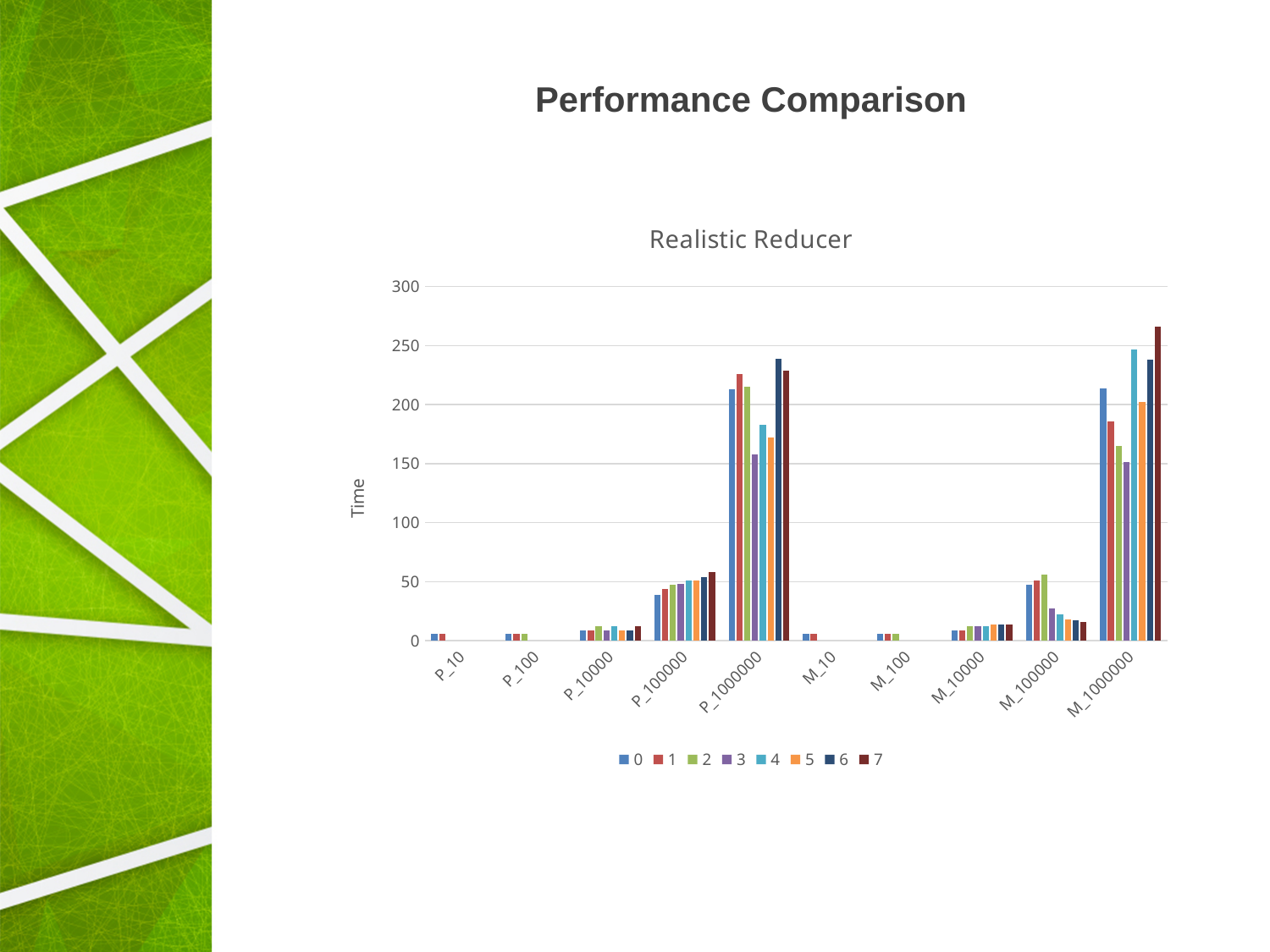
Which series has the tallest bar in the M_1000000 category? 7 Is the value for series 0 at P_100000 greater or less than 50? less Is the value for series 3 at P_1000000 greater or less than 200? less For series 0, which is larger: the value at P_1000000 or the value at M_10? P_1000000 How many series does the legend list? 8 What kind of chart is shown on the slide? bar chart What is the label on the vertical axis of the chart? Time Is the value for series 4 at M_1000000 greater or less than 200? greater What is the title of the chart? Realistic Reducer Which category contains the tallest bar in the chart? M_1000000 How many categories are shown along the x axis of the chart? 10